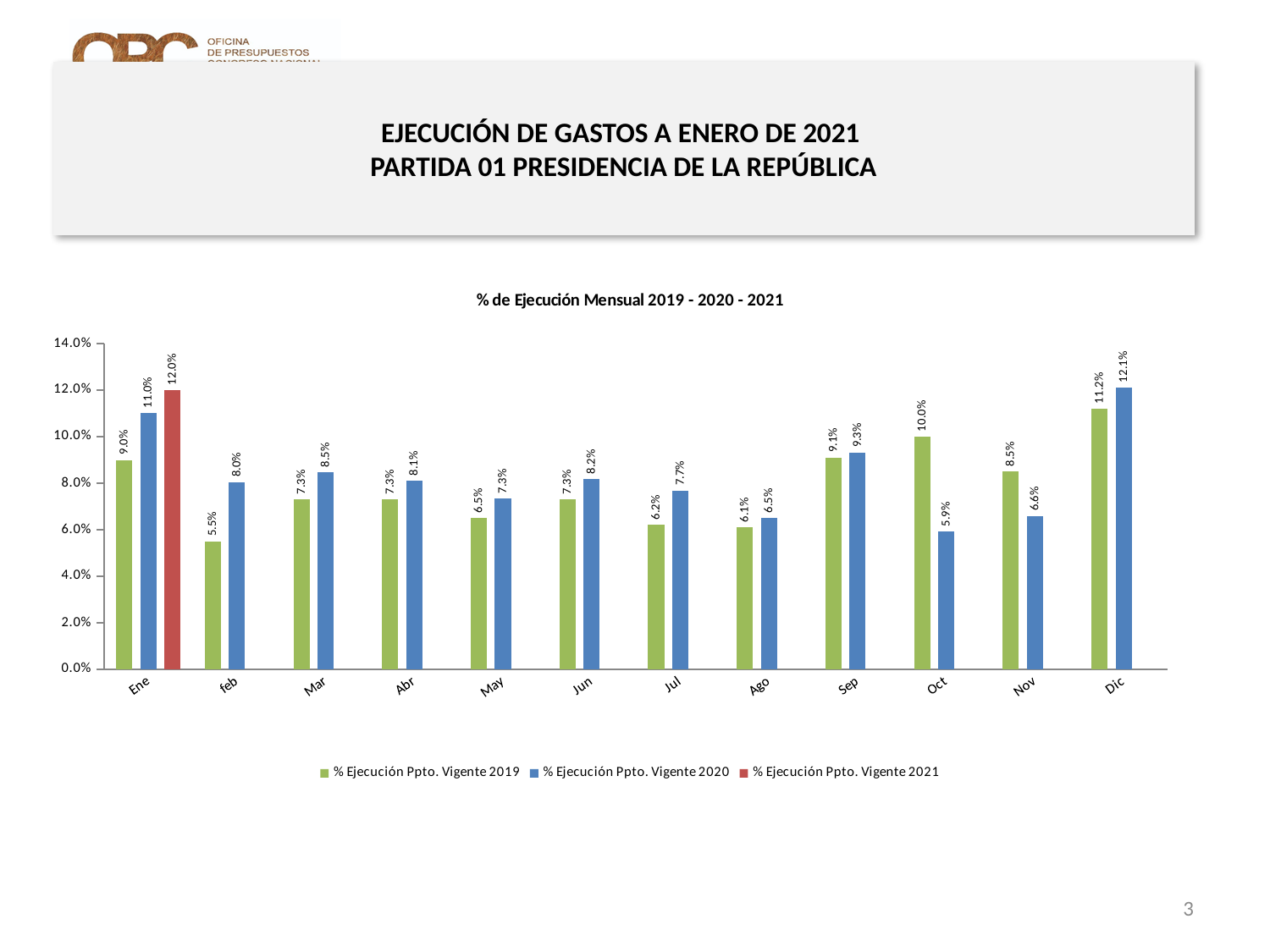
Is the value for % Ejecución Ppto. Vigente 2020 in Dic greater or less than 12.0%? greater How many months are shown on the x axis? 12 How many series does the legend list? 3 What is the difference between the 2020 and 2019 values in feb? 2.5% What is the title of the chart? % de Ejecución Mensual 2019 - 2020 - 2021 Which month has the lowest value for % Ejecución Ppto. Vigente 2019? feb What is the value for % Ejecución Ppto. Vigente 2020 in Nov? 6.6% What is the value for % Ejecución Ppto. Vigente 2021 in Ene? 12.0% In Oct, which series has the larger value, 2019 or 2020? % Ejecución Ppto. Vigente 2019 What is the value for % Ejecución Ppto. Vigente 2019 in Oct? 10.0% What kind of chart is shown on the slide? Bar chart Which month has the highest value for % Ejecución Ppto. Vigente 2020? Dic